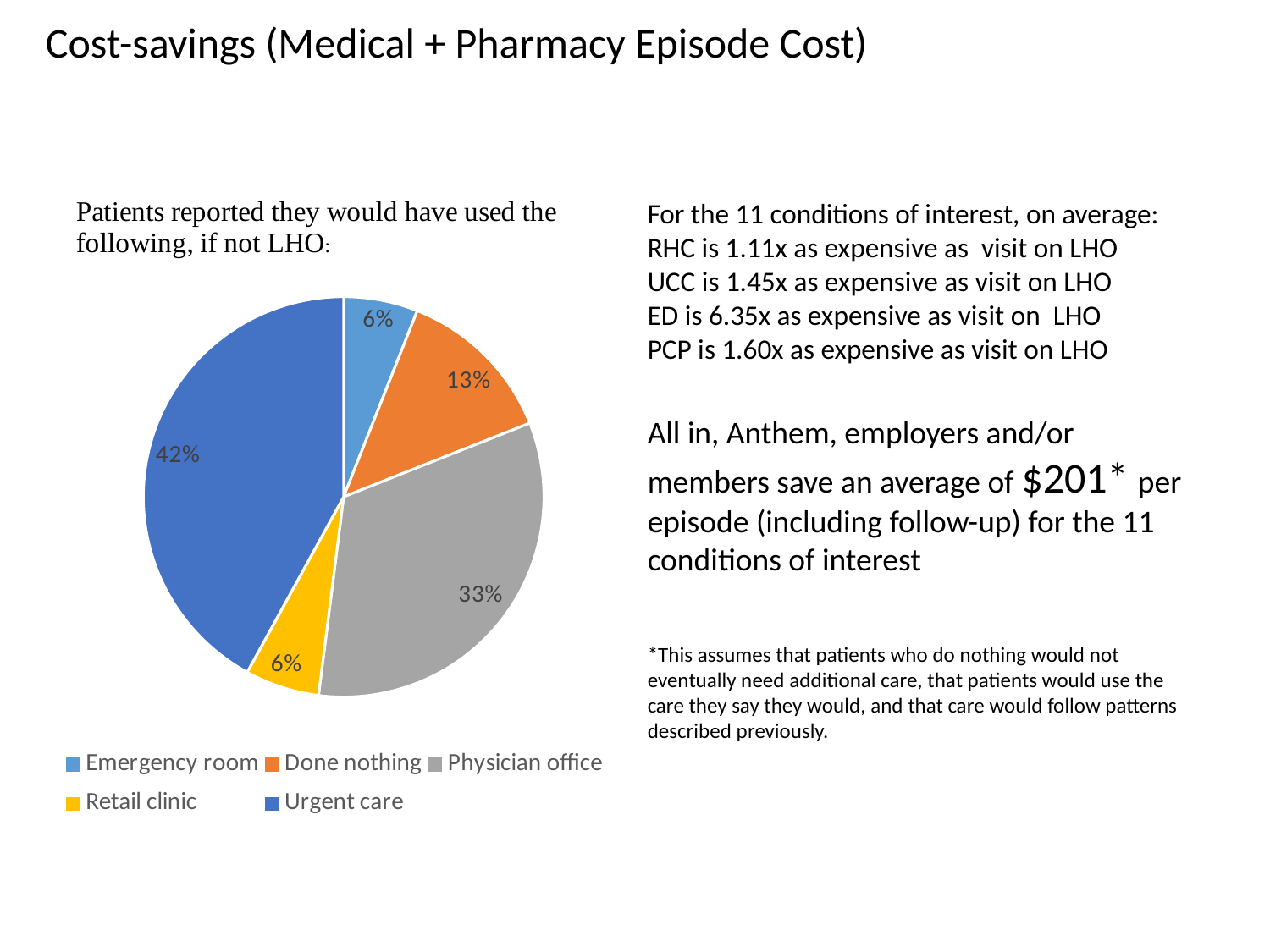
What percentage of patients reported they would have used a Physician office? 33% What percentage is shown for Retail clinic? 6% Which category is shown in yellow in the legend? Retail clinic What is the difference in percentage points between Urgent care and Physician office? 9 Which category has the largest slice of the pie? Urgent care What percentage is shown for Emergency room? 6% What is the difference in percentage points between Physician office and Done nothing? 20 What share of the pie does Urgent care represent? 42% How many categories does the pie chart show? 5 Which is larger, the share for Done nothing or the share for Physician office? Physician office What is the value shown for Done nothing? 13% What kind of chart is shown on the slide? Pie chart